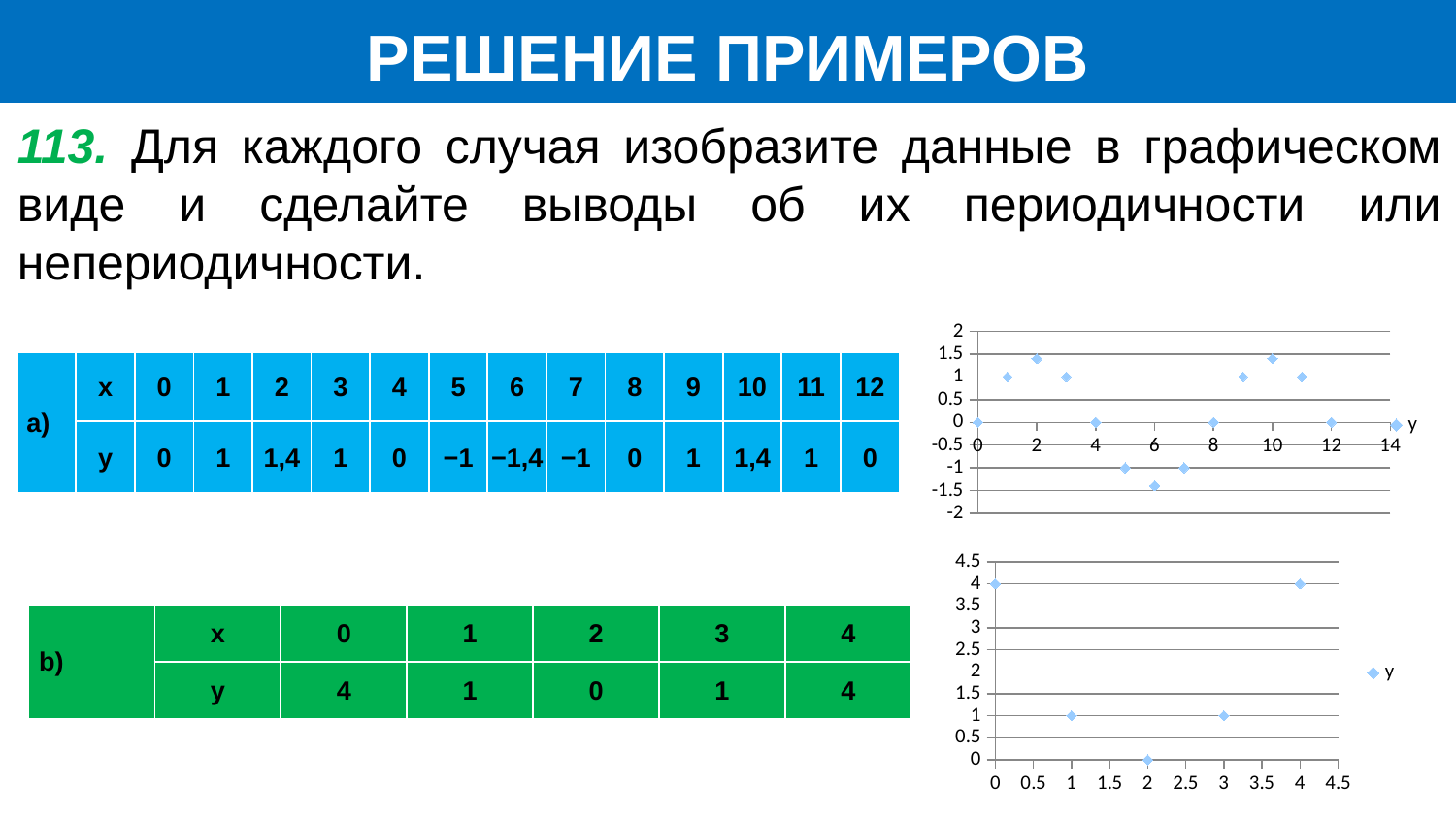
In the bottom chart, which has the larger y value: x = 0 or x = 1? x = 0 In the bottom chart, what is the y value at x = 4? 4 In the top chart, is the y value at x = 2 greater or less than 1? greater How many series does the legend of the top chart list? 1 How many data points are plotted in the bottom chart on the right of the slide? 5 How many data points are plotted in the top chart on the right of the slide? 13 In the top chart, at which x value is the lowest y value plotted? 6 In the bottom chart, do the y values rise or fall as x goes from 0 to 2? fall What kind of chart is the top chart on the right of the slide? scatter chart In the bottom chart, what is the highest y value plotted? 4 In the bottom chart, what is the y value at x = 2? 0 In the bottom chart, what is the difference between the y value at x = 0 and the y value at x = 1? 3